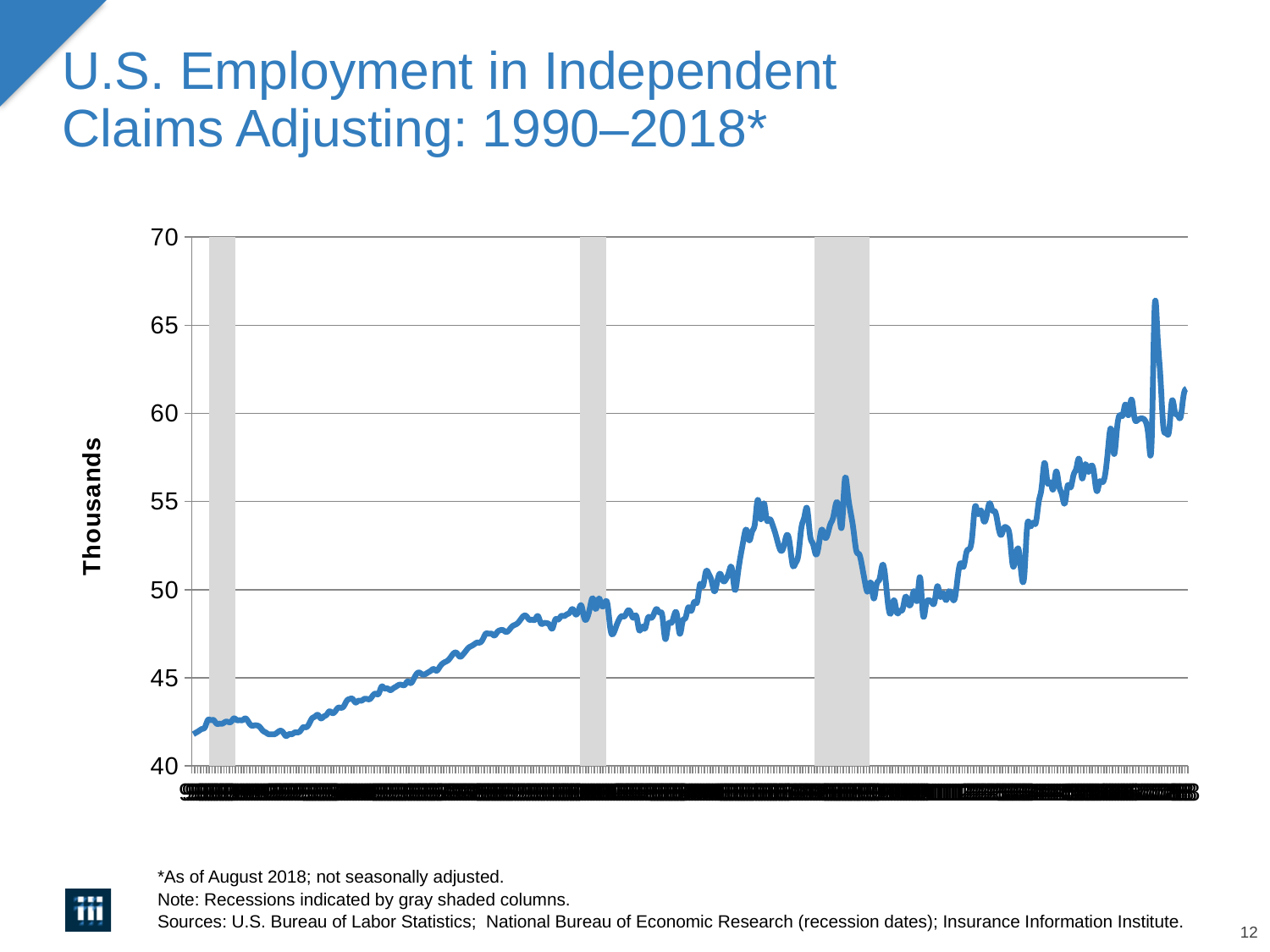
Is the value at the end of the series (right end of the line) greater or less than 60? greater Which is larger, the value at the left end of the line or the value at the right end of the line? the right end Is the highest point on the line greater or less than 65? greater Overall, do the values rise or fall from the left of the x axis to the right? rise Is the lowest point on the line greater or less than 45? less What kind of chart is shown on the slide? line chart How many gray shaded recession columns are shown on the chart? 3 What is the label on the vertical axis? Thousands